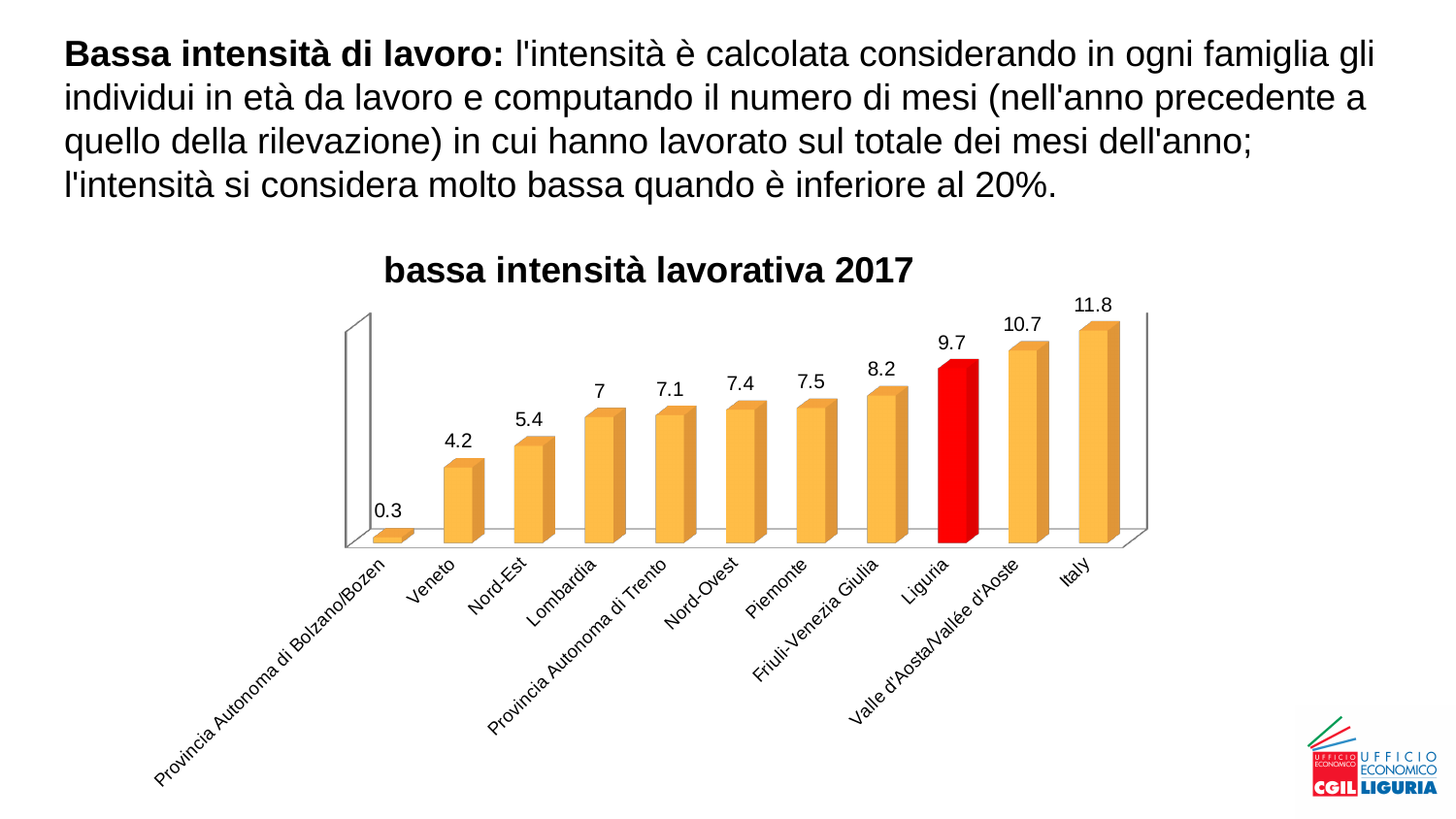
Which category has the highest value? Italy What is the value for Liguria in the chart? 9.7 What is the value for Italy? 11.8 What kind of chart is shown on the slide? Bar chart Which bar is coloured red in the chart? Liguria What is the value for Provincia Autonoma di Trento? 7.1 What is the difference between the values for Valle d'Aosta/Vallée d'Aoste and Veneto? 6.5 What is the value for Veneto? 4.2 How many categories are shown in the chart? 11 What is the difference between the values for Italy and Liguria? 2.1 Which category has the lowest value? Provincia Autonoma di Bolzano/Bozen Which has a larger value, Piemonte or Lombardia? Piemonte